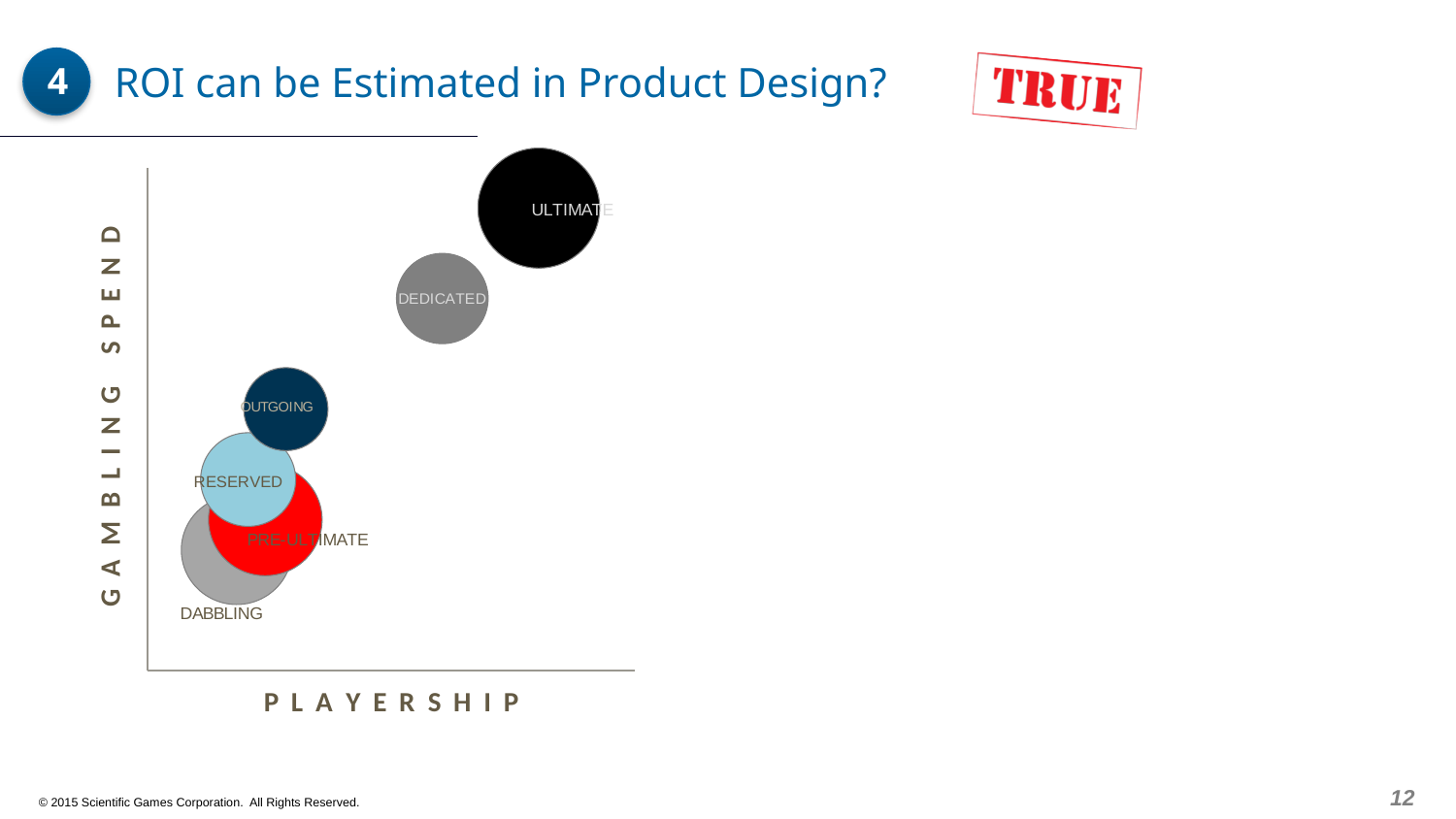
What is the label of the horizontal axis of the chart? PLAYERSHIP How many bubbles (player segments) are plotted on the chart? 6 What is the label of the vertical axis of the chart? GAMBLING SPEND As playership increases along the x axis, does gambling spend rise or fall? Rise What kind of chart is shown on the slide? Bubble chart Which segment has higher gambling spend, OUTGOING or RESERVED? OUTGOING Which segment has the lowest gambling spend on the chart? DABBLING Which segment has the highest gambling spend on the chart? ULTIMATE Which segment is further along the playership axis, DEDICATED or OUTGOING? DEDICATED Which segment is further along the playership axis, ULTIMATE or DEDICATED? ULTIMATE